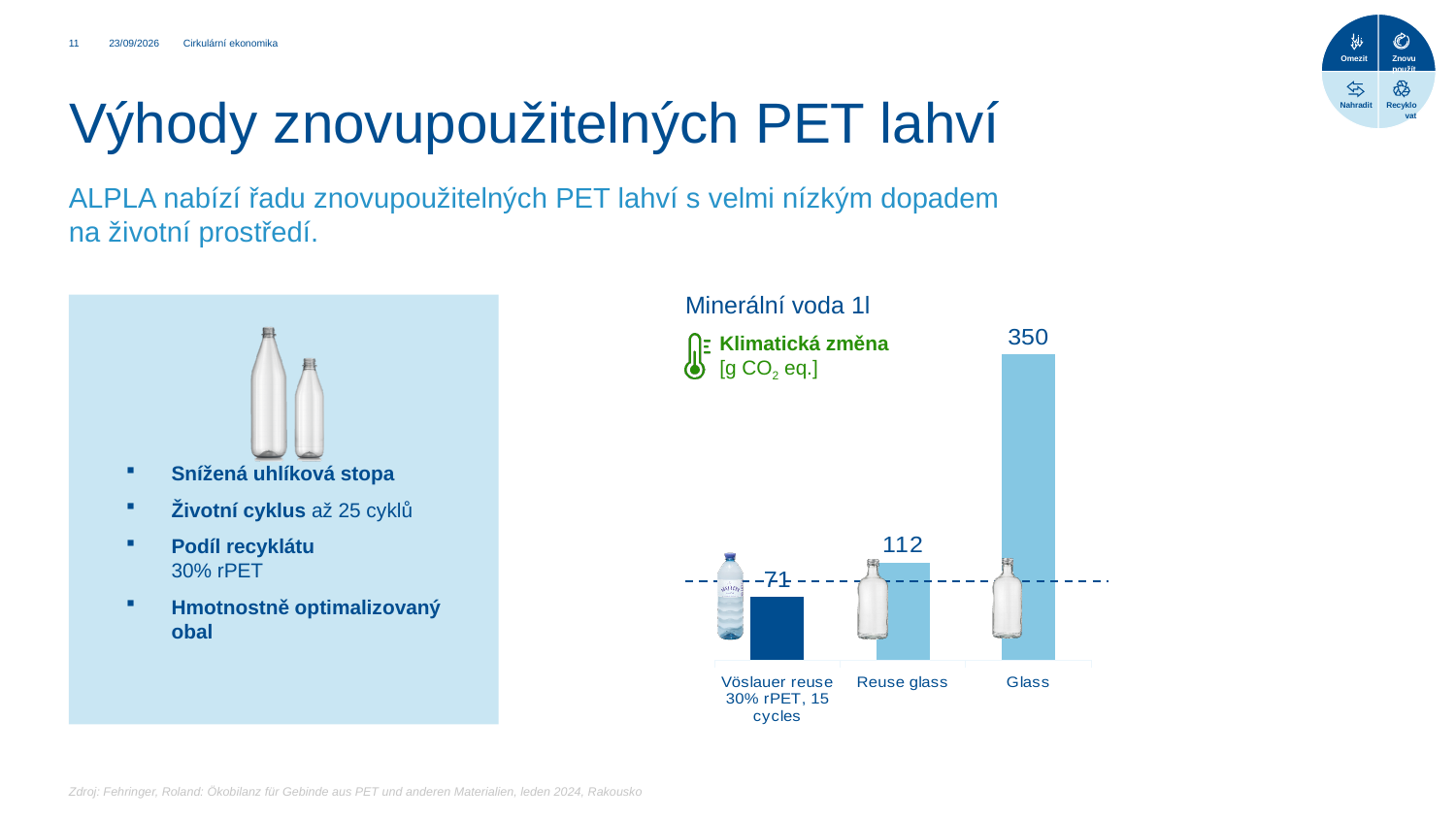
What unit is given for the climate change values in the chart? g CO2 eq. Which is larger, the value for Reuse glass or the value for Vöslauer reuse 30% rPET, 15 cycles? Reuse glass What is the value for Glass in the chart? 350 What is the value for Vöslauer reuse 30% rPET, 15 cycles in the chart? 71 Which category has the lowest value in the chart? Vöslauer reuse 30% rPET, 15 cycles What kind of chart is shown on the slide? Bar chart Do the values rise or fall from left to right across the chart? Rise How many categories are shown in the chart? 3 What is the difference between the values for Reuse glass and Vöslauer reuse 30% rPET, 15 cycles? 41 Which category has the highest value in the chart? Glass What is the difference between the values for Glass and Reuse glass? 238 What is the value for Reuse glass in the chart? 112